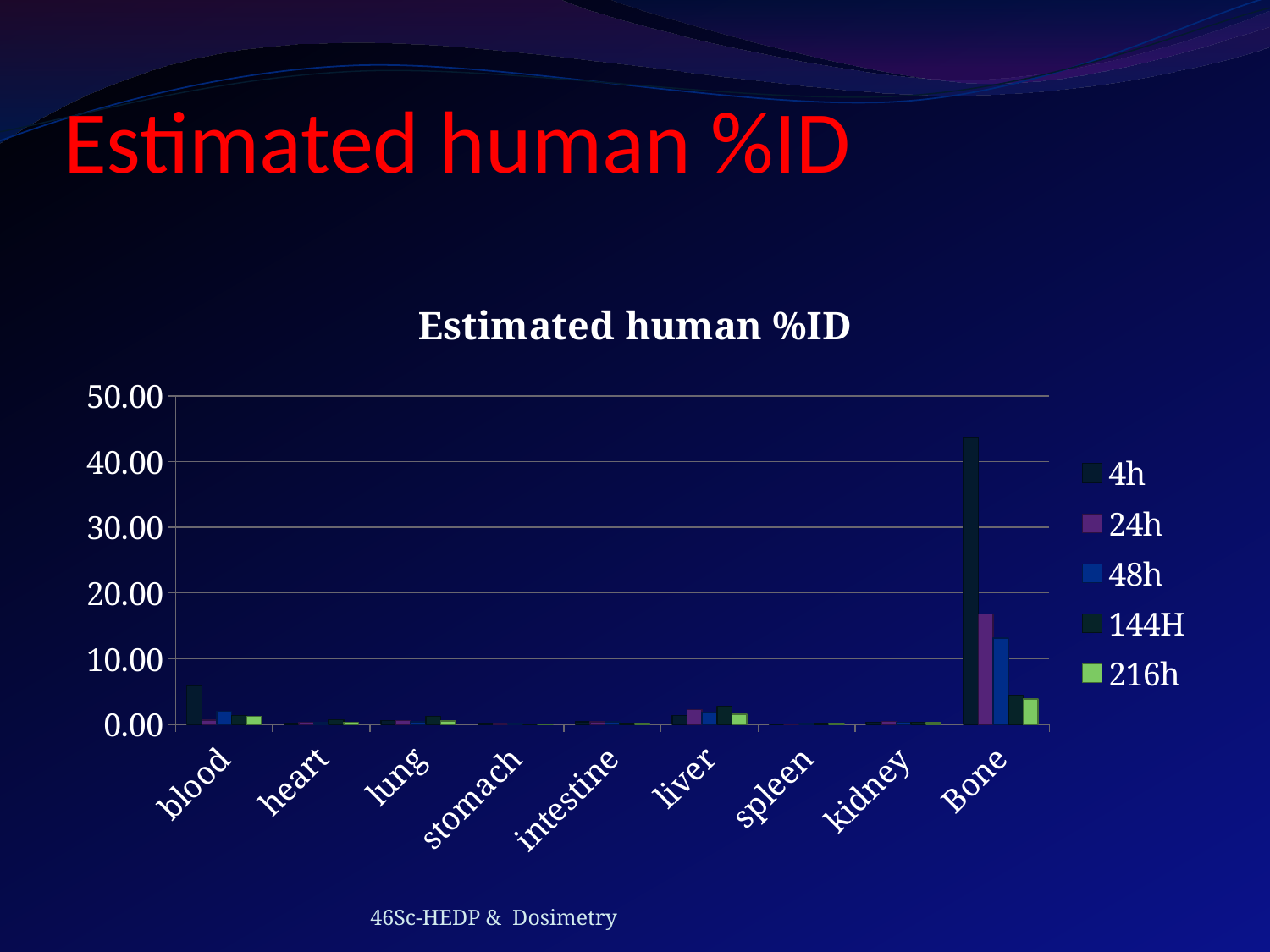
Is the 4h value for Bone greater or less than 40.00? greater What kind of chart is shown on the slide? bar chart Which is larger for Bone: the 4h value or the 48h value? 4h Which category has the highest value for the 4h series? Bone Which category has the tallest bar overall in the chart? Bone Is the 24h value for Bone greater or less than 20.00? less Is the 24h value for Bone greater or less than 10.00? greater Which series is shown in green in the legend? 216h What is the title of the chart? Estimated human %ID How many organ categories are shown on the x axis of the chart? 9 How many series does the chart's legend list? 5